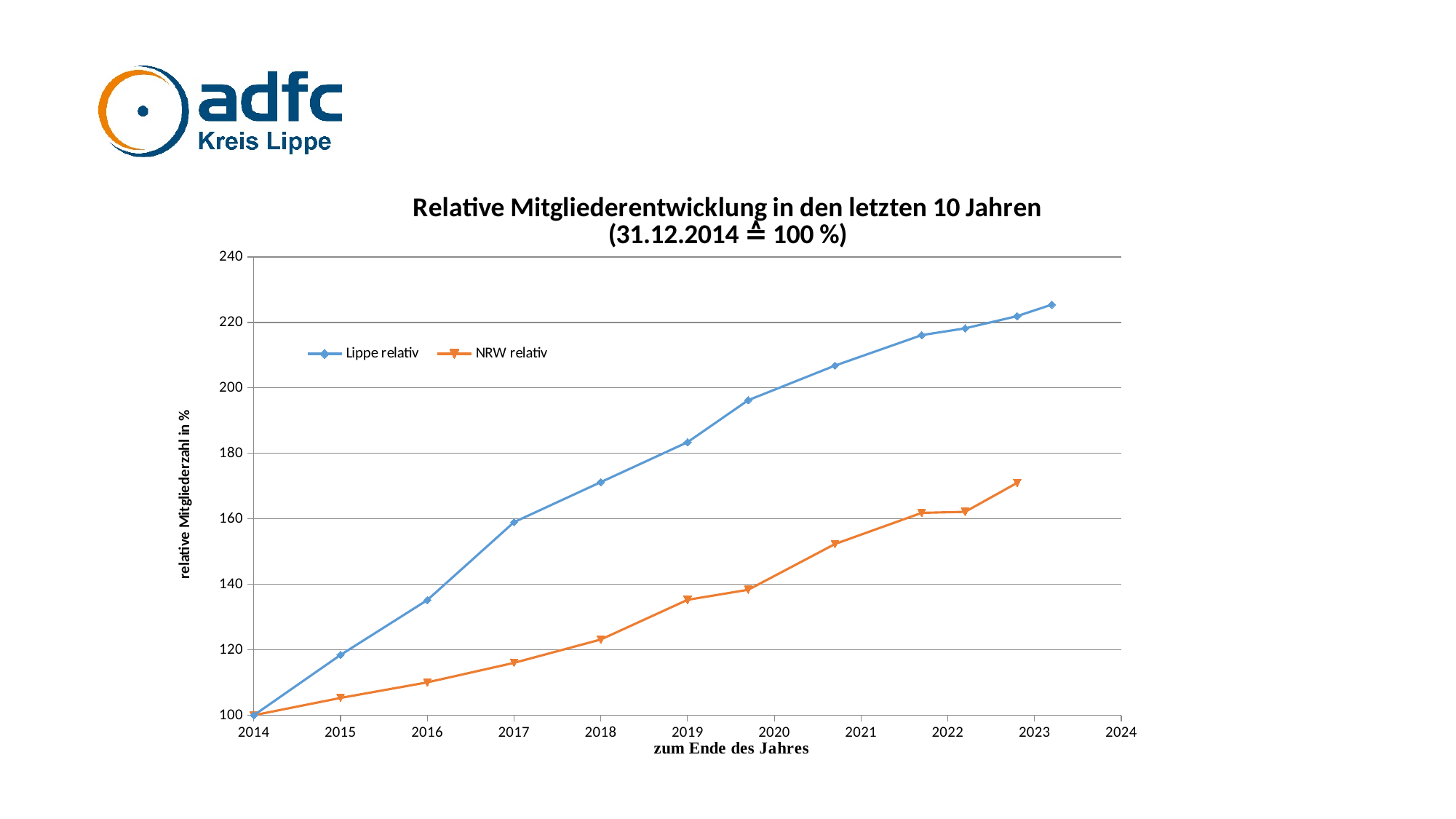
Is the value for NRW relativ in 2021 greater or less than 140? greater What is the label of the vertical axis? relative Mitgliederzahl in % What is the value of NRW relativ in 2014? 100 Is the value for NRW relativ in 2019 greater or less than 140? less Which series is higher in 2023, Lippe relativ or NRW relativ? Lippe relativ Is the value for Lippe relativ in 2021 greater or less than 200? greater What kind of chart is shown on the slide? line chart Do the values of Lippe relativ rise or fall from 2014 to 2023? rise What are the two series named in the legend? Lippe relativ and NRW relativ How many series does the legend list? 2 What is the value of Lippe relativ in 2014? 100